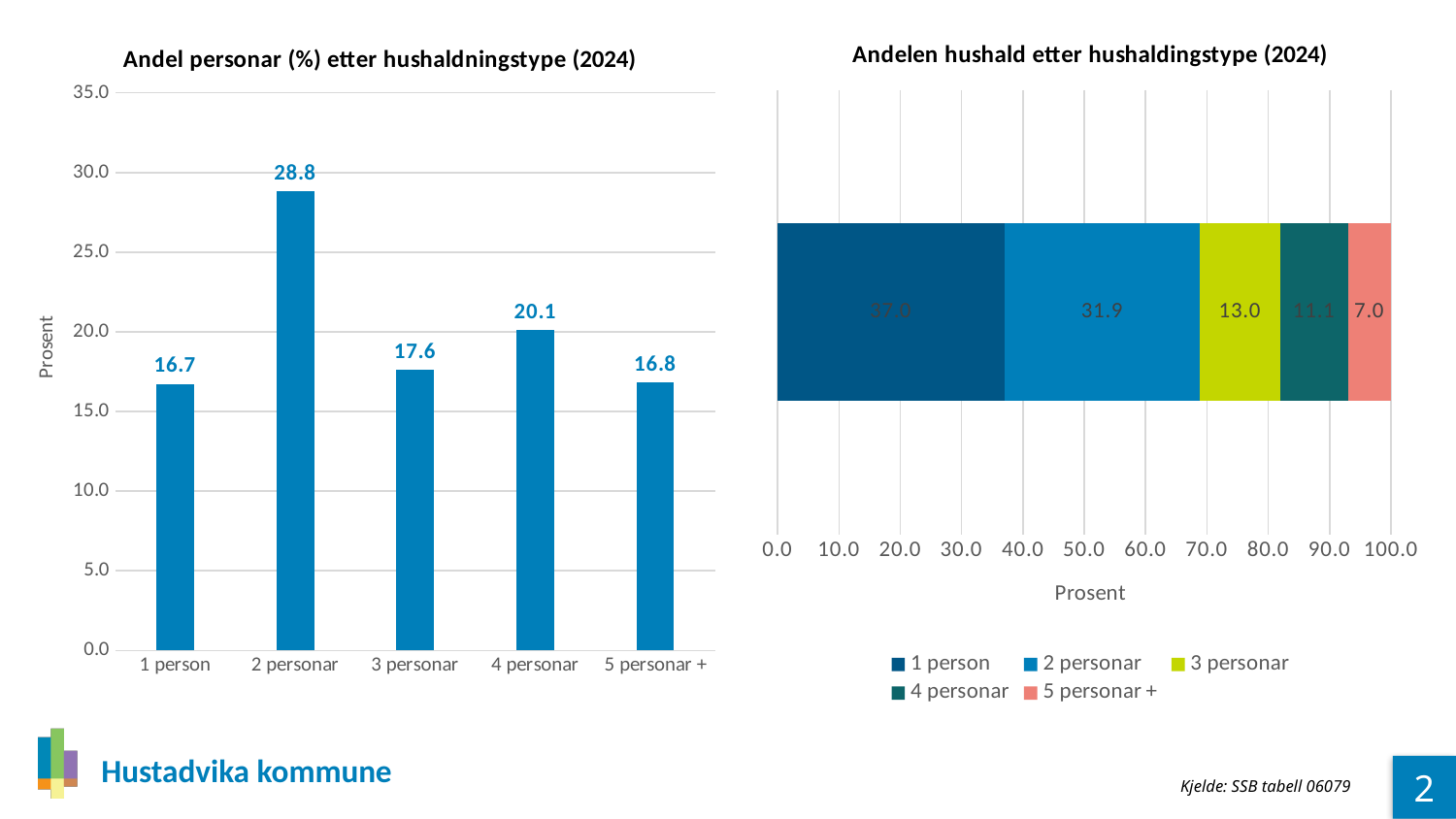
In the right chart 'Andelen hushald etter hushaldingstype (2024)', how many series does the legend list? 5 What kind of chart is the left chart 'Andel personar (%) etter hushaldningstype (2024)'? Bar chart In the left chart 'Andel personar (%) etter hushaldningstype (2024)', how many household types are shown on the x axis? 5 In the right chart 'Andelen hushald etter hushaldingstype (2024)', what is the value for 2 personar? 31.9 In the left chart 'Andel personar (%) etter hushaldningstype (2024)', which is larger: the value for 3 personar or the value for 4 personar? 4 personar In the left chart 'Andel personar (%) etter hushaldningstype (2024)', what is the difference between the values for 2 personar and 1 person? 12.1 In the right chart 'Andelen hushald etter hushaldingstype (2024)', what is the total of the stacked bar? 100.0 In the left chart 'Andel personar (%) etter hushaldningstype (2024)', what is the value for 2 personar? 28.8 In the left chart 'Andel personar (%) etter hushaldningstype (2024)', which household type has the highest value? 2 personar In the right chart 'Andelen hushald etter hushaldingstype (2024)', what is the value for 3 personar? 13.0 In the right chart 'Andelen hushald etter hushaldingstype (2024)', which household type has the smallest segment? 5 personar + In the left chart 'Andel personar (%) etter hushaldningstype (2024)', what is the value for 4 personar? 20.1